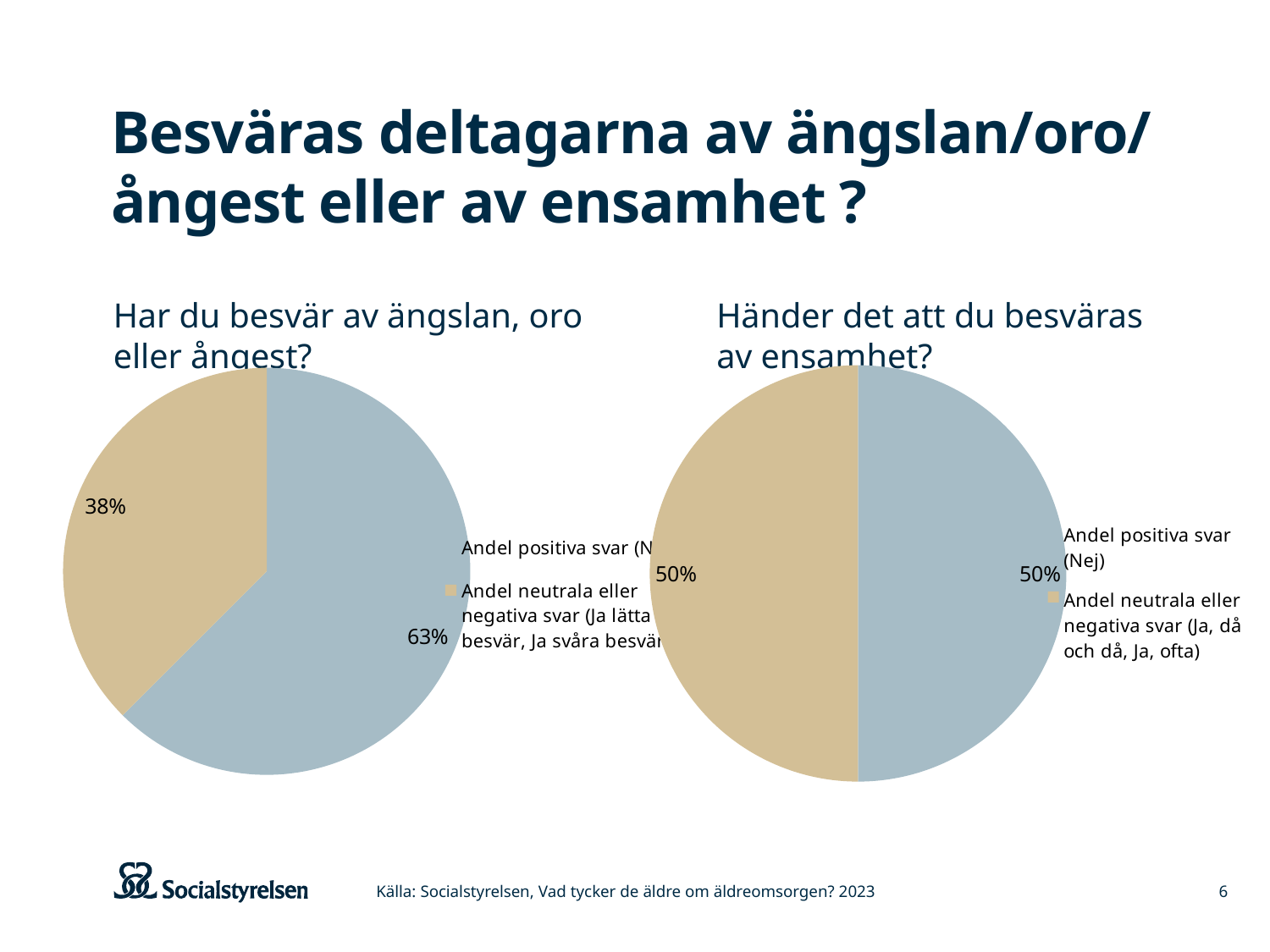
In the chart 'Händer det att du besväras av ensamhet?', what share is labelled for the positive answers (Nej) slice? 50% In the chart 'Har du besvär av ängslan, oro eller ångest?', which slice is the largest? Andel positiva svar (Nej) In the chart 'Har du besvär av ängslan, oro eller ångest?', is the share of positive answers (Nej) greater or less than 50%? greater In the chart 'Har du besvär av ängslan, oro eller ångest?', what is the difference in percentage points between the two slices? 25 percentage points In the chart 'Händer det att du besväras av ensamhet?', what share is labelled for the neutral or negative answers slice? 50% What kind of chart is used for 'Har du besvär av ängslan, oro eller ångest?'? Pie chart In the chart 'Har du besvär av ängslan, oro eller ångest?', what share is labelled for the positive answers (Nej) slice? 63% In the chart 'Händer det att du besväras av ensamhet?', what colour is the slice for 'Andel positiva svar (Nej)'? Blue-grey In the chart 'Har du besvär av ängslan, oro eller ångest?', what share is labelled for the neutral or negative answers slice? 38% How many entries does the legend of the chart 'Händer det att du besväras av ensamhet?' list? 2 How many pie charts are shown on the slide? 2 How many slices does the chart 'Händer det att du besväras av ensamhet?' have? 2